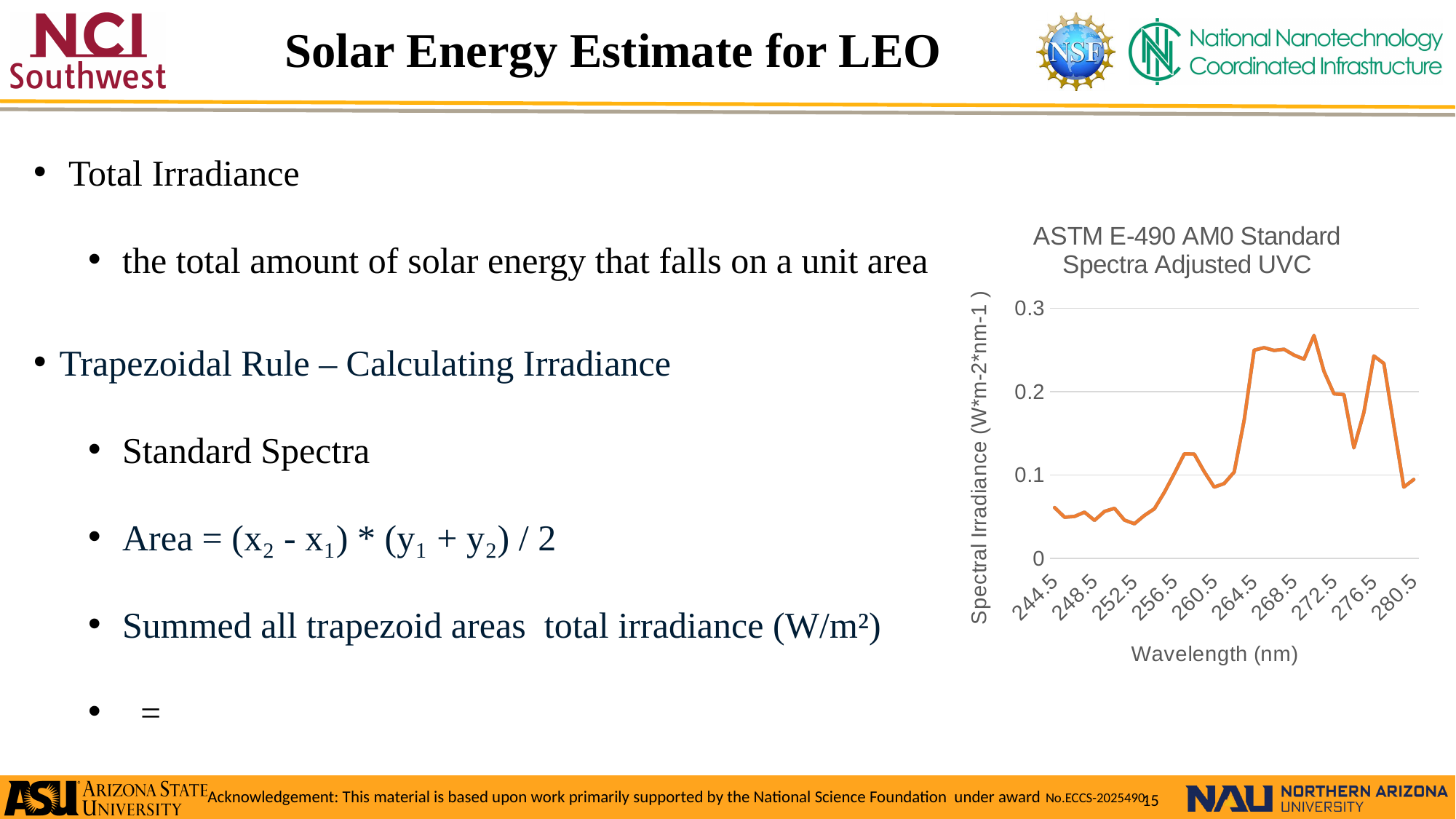
Which wavelength has the higher spectral irradiance, 244.5 nm or 268.5 nm? 268.5 nm Which wavelength has the higher spectral irradiance, 252.5 nm or 276.5 nm? 276.5 nm Is the spectral irradiance at 252.5 nm greater or less than 0.1? less What kind of chart is shown on the slide? line chart Is the spectral irradiance at 268.5 nm greater or less than 0.2? greater Is the spectral irradiance at 244.5 nm greater or less than 0.1? less How many wavelength tick labels are shown on the x axis of the chart? 10 What is the title of the chart? ASTM E-490 AM0 Standard Spectra Adjusted UVC What is the label of the x axis of the chart? Wavelength (nm) Does the spectral irradiance rise or fall between 276.5 nm and 280.5 nm? fall